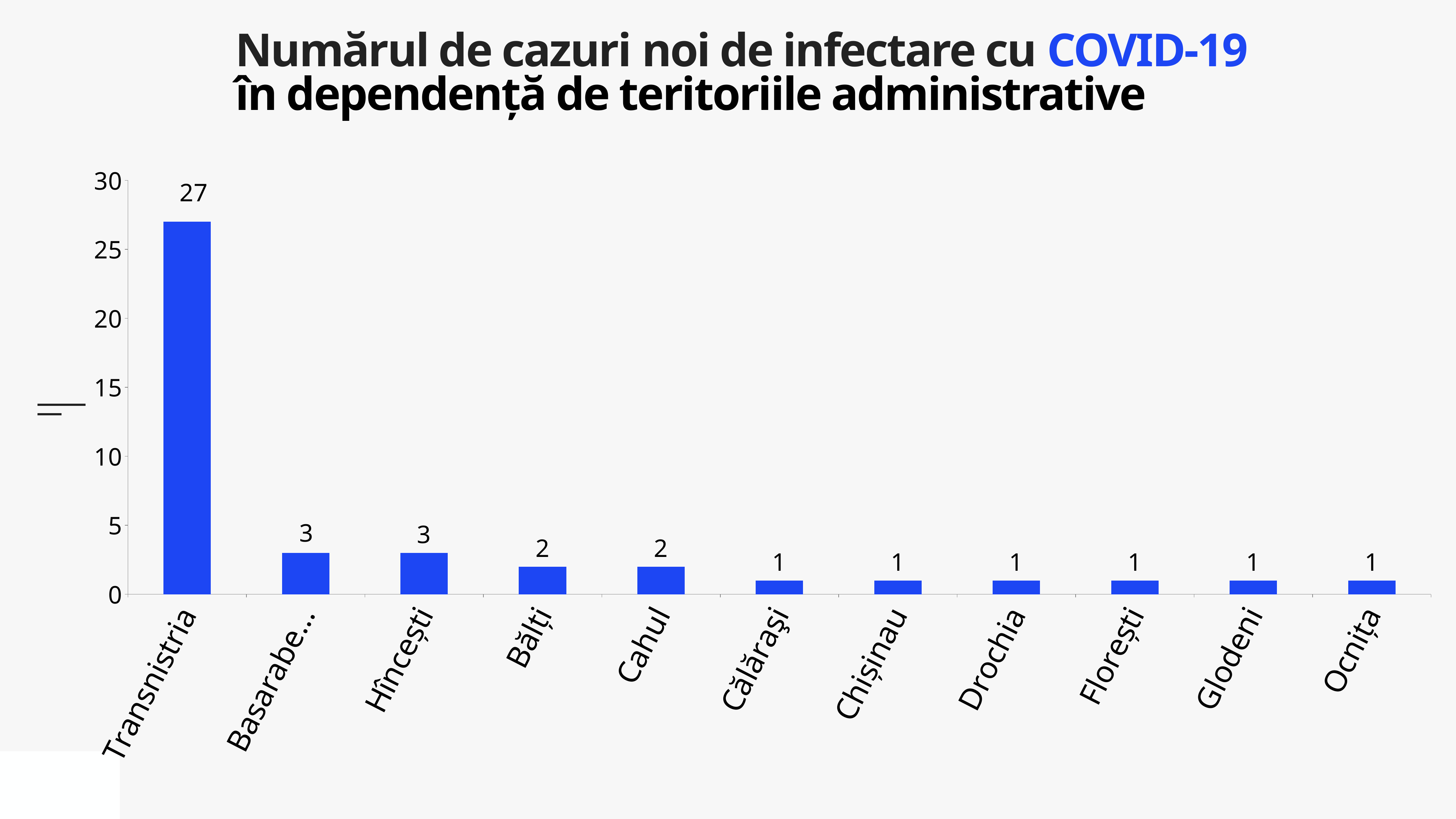
What is the value for Chișinau? 1 Is the value for Transnistria greater or less than 25? greater How many new COVID-19 cases are shown for Transnistria? 27 What is the title of the chart? Numărul de cazuri noi de infectare cu COVID-19 în dependență de teritoriile administrative What type of chart is shown on the slide? bar chart Which is larger, the value for Hîncești or the value for Bălți? Hîncești What is the value for Hîncești? 3 Which territory has the highest number of new cases? Transnistria What is the value for Bălți? 2 What is the value for Cahul? 2 What is the difference between the values for Transnistria and Hîncești? 24 How many territories are shown on the x axis? 11